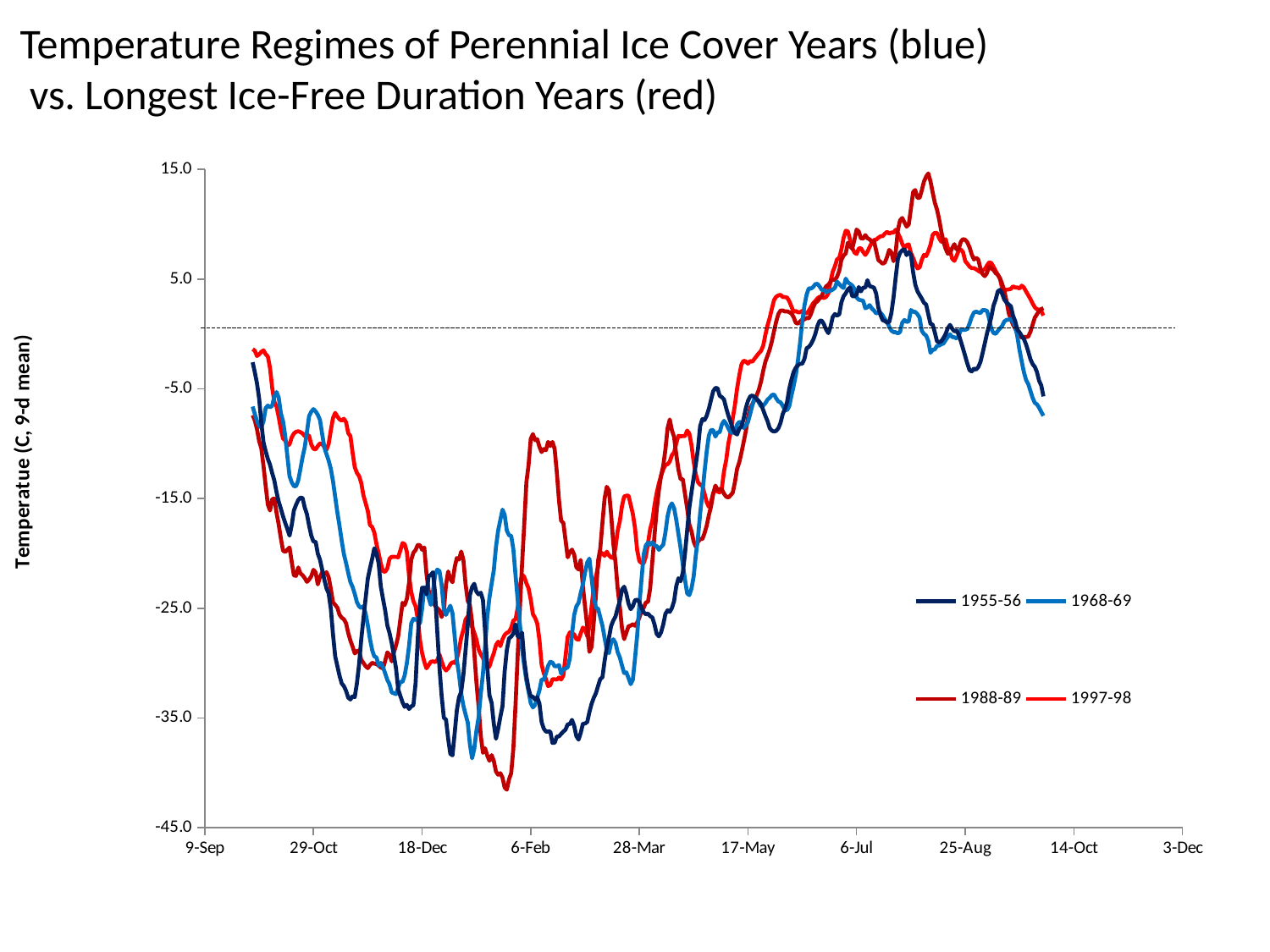
Do the temperature values generally rise or fall between 9-Sep and 18-Dec? fall What is the label of the vertical axis? Temperature (C, 9-d mean) How many series does the legend list? 4 Is the peak value of the 1968-69 series greater or less than 10? less Do the temperature values generally rise or fall between 28-Mar and 6-Jul? rise Is the lowest value of the 1997-98 series greater or less than -35? greater Is the peak value of the 1988-89 series greater or less than 10? greater What kind of chart is shown on the slide? line chart What is the highest value shown on the vertical axis? 15.0 Around 6-Jul, which series has the higher value: 1988-89 or 1968-69? 1988-89 Which series reaches the highest temperature on the chart? 1988-89 Which series are shown in red according to the legend? 1988-89 and 1997-98